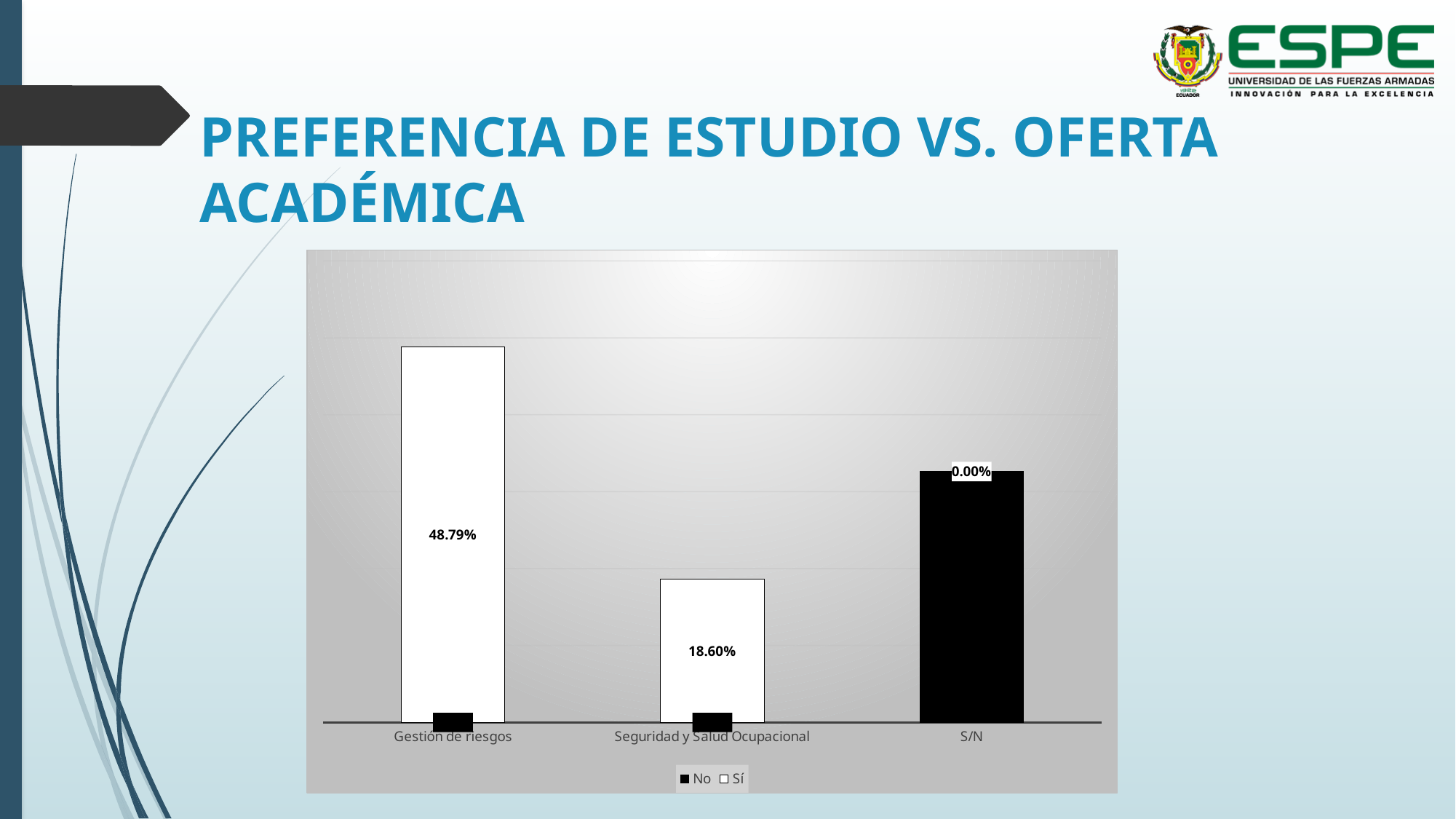
How many categories are shown on the x axis? 3 What colour represents the No series? Black Which category has the highest Sí value? Gestión de riesgos What kind of chart is shown on the slide? Bar chart Which is larger, the Sí value for Gestión de riesgos or for Seguridad y Salud Ocupacional? Gestión de riesgos What is the value of the Sí bar for Gestión de riesgos? 48.79% What are the two series named in the legend? No and Sí How many series does the legend list? 2 Which category is labelled S/N on the x axis: the first, second or third? Third What is the value of the Sí bar for Seguridad y Salud Ocupacional? 18.60% What is the difference between the Sí values for Gestión de riesgos and Seguridad y Salud Ocupacional? 30.19%